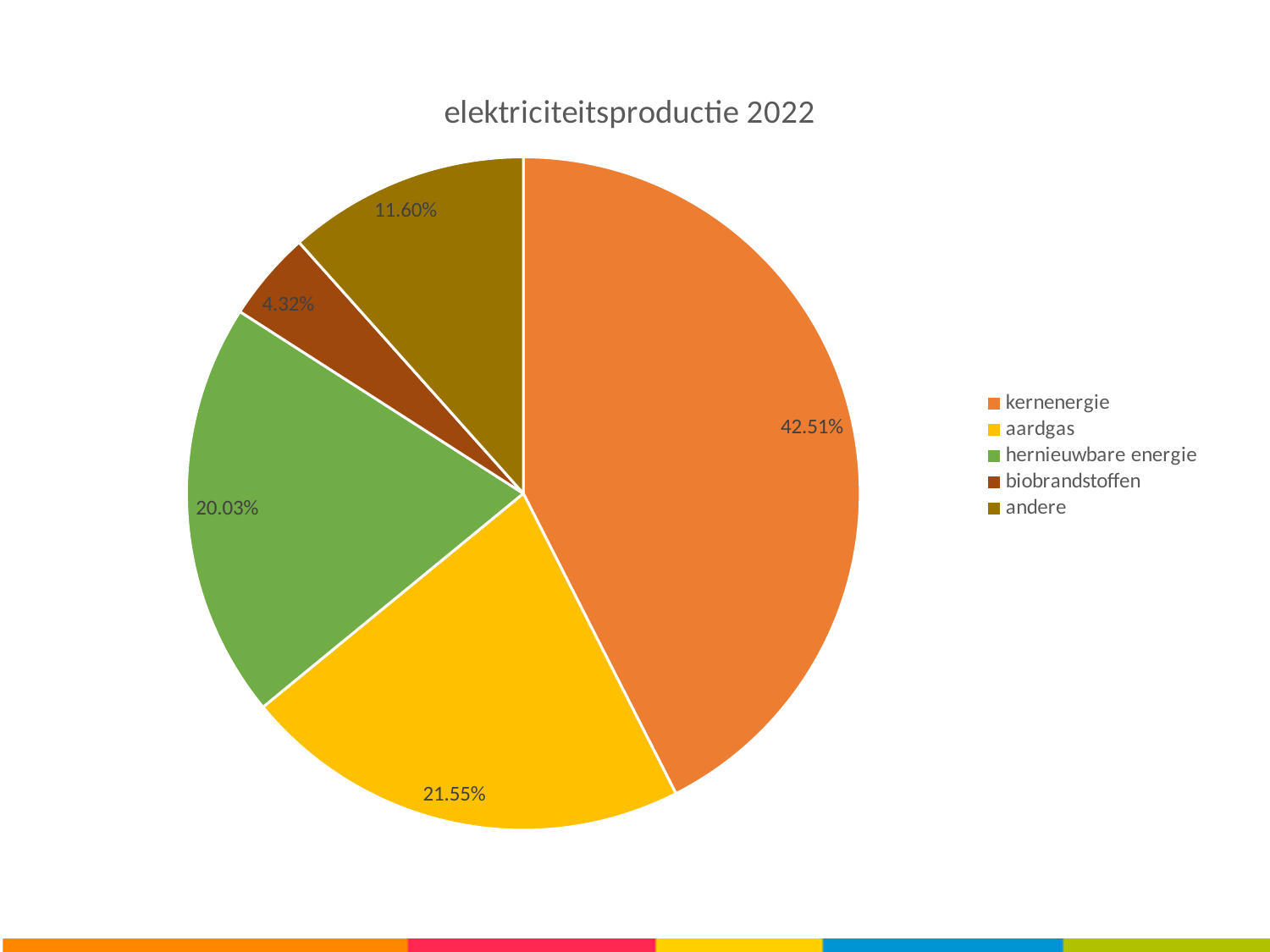
What is the difference between the share for kernenergie and the share for aardgas? 20.96% What share of the pie does biobrandstoffen have? 4.32% What share of the pie does aardgas have? 21.55% Which is larger, the share for andere or the share for biobrandstoffen? andere What type of chart is shown on the slide? pie chart How many categories does the legend list? 5 What share of the pie does kernenergie have? 42.51% What is the title of the chart? elektriciteitsproductie 2022 Which category has the smallest slice of the pie? biobrandstoffen What share of the pie does andere have? 11.60% What share of the pie does hernieuwbare energie have? 20.03% Which category has the largest slice of the pie? kernenergie